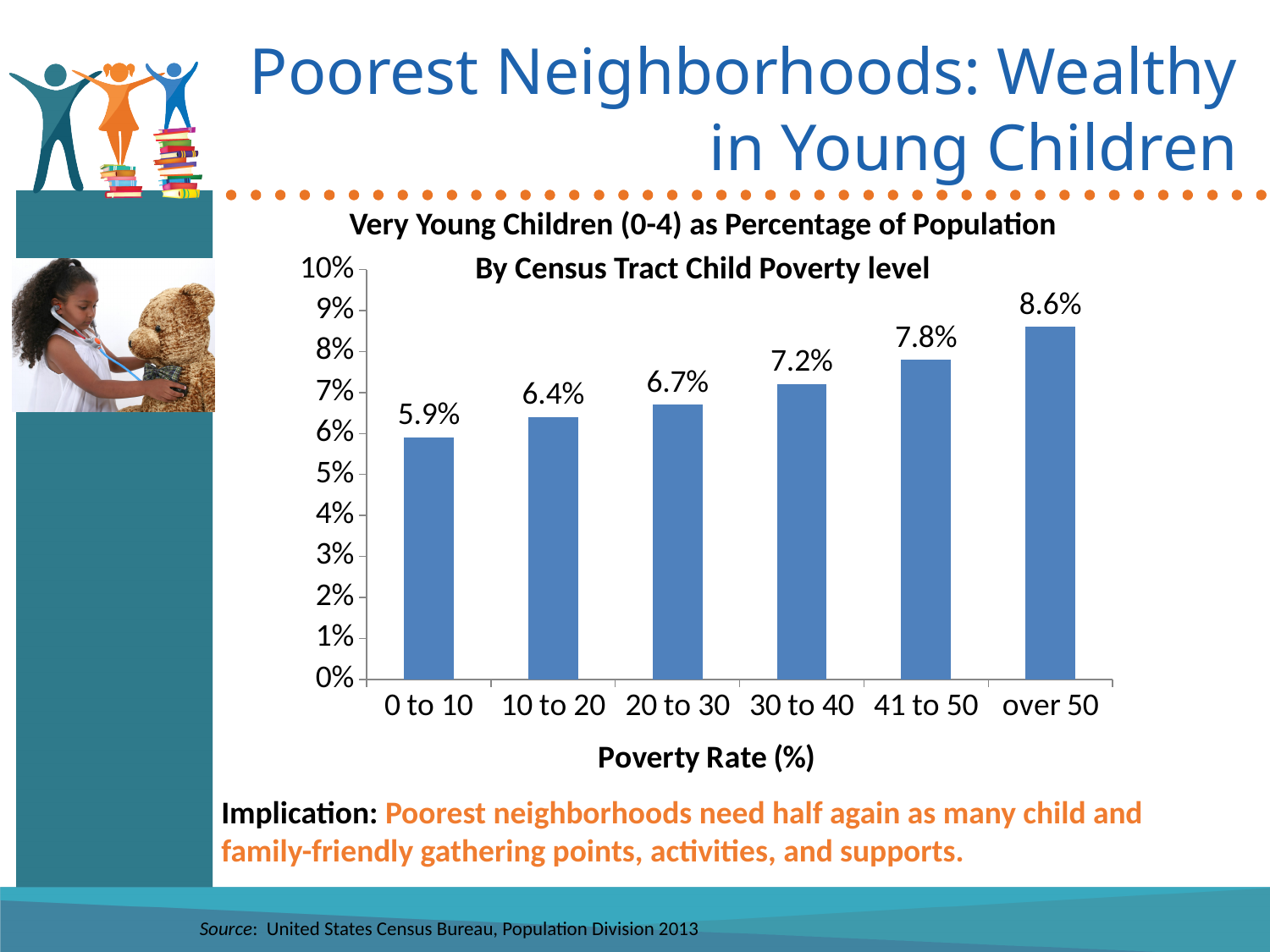
Which is larger, the value for "20 to 30" or the value for "41 to 50"? 41 to 50 Which poverty rate category has the lowest percentage of very young children? 0 to 10 How many poverty rate categories are shown on the chart? 6 Is the value for "10 to 20" greater or less than 7%? less What is the value for the "30 to 40" poverty rate category? 7.2% What kind of chart is shown on the slide? bar chart What is the difference between the values for "over 50" and "0 to 10"? 2.7% Which poverty rate category has the highest percentage of very young children? over 50 What is the difference between the values for "41 to 50" and "10 to 20"? 1.4% Do the values rise or fall as the poverty rate increases along the x axis? rise What is the value for the "over 50" poverty rate category? 8.6% What is the value for the "0 to 10" poverty rate category? 5.9%